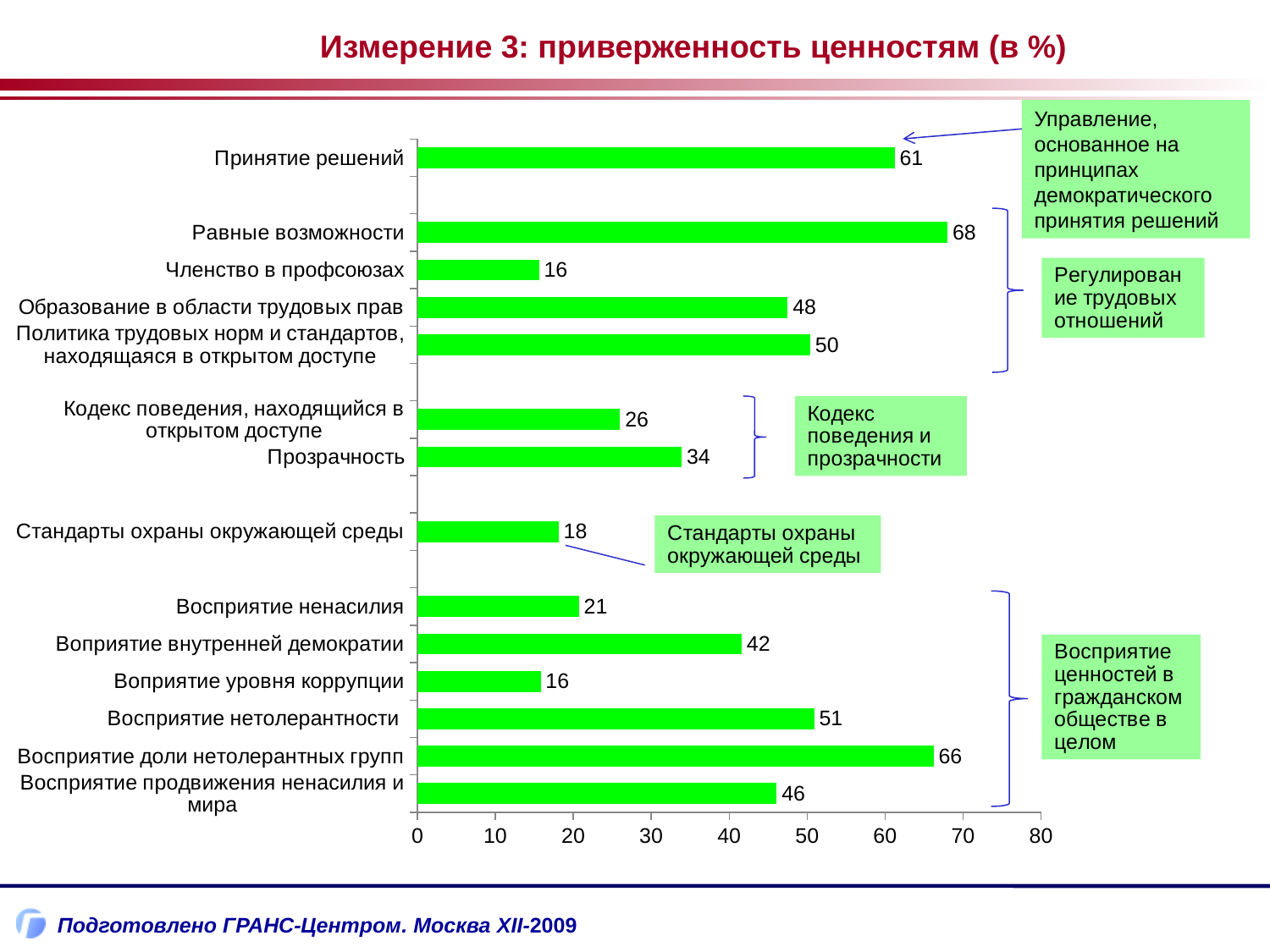
What is the value for Прозрачность? 34 What kind of chart is shown on the slide? Bar chart What is the difference between the values for Восприятие нетолерантности and Восприятие ненасилия? 30 What is the value for Стандарты охраны окружающей среды? 18 What is the title of the slide? Измерение 3: приверженность ценностям (в %) How many bars are shown on the chart? 14 Which is larger: the value for Образование в области трудовых прав or the value for Вопритие внутренней демократии? Образование в области трудовых прав What is the value for Восприятие доли нетолерантных групп? 66 What is the lowest value shown on the chart? 16 What is the value for Принятие решений? 61 What is the difference between the values for Равные возможности and Членство в профсоюзах? 52 Which category has the highest value? Равные возможности